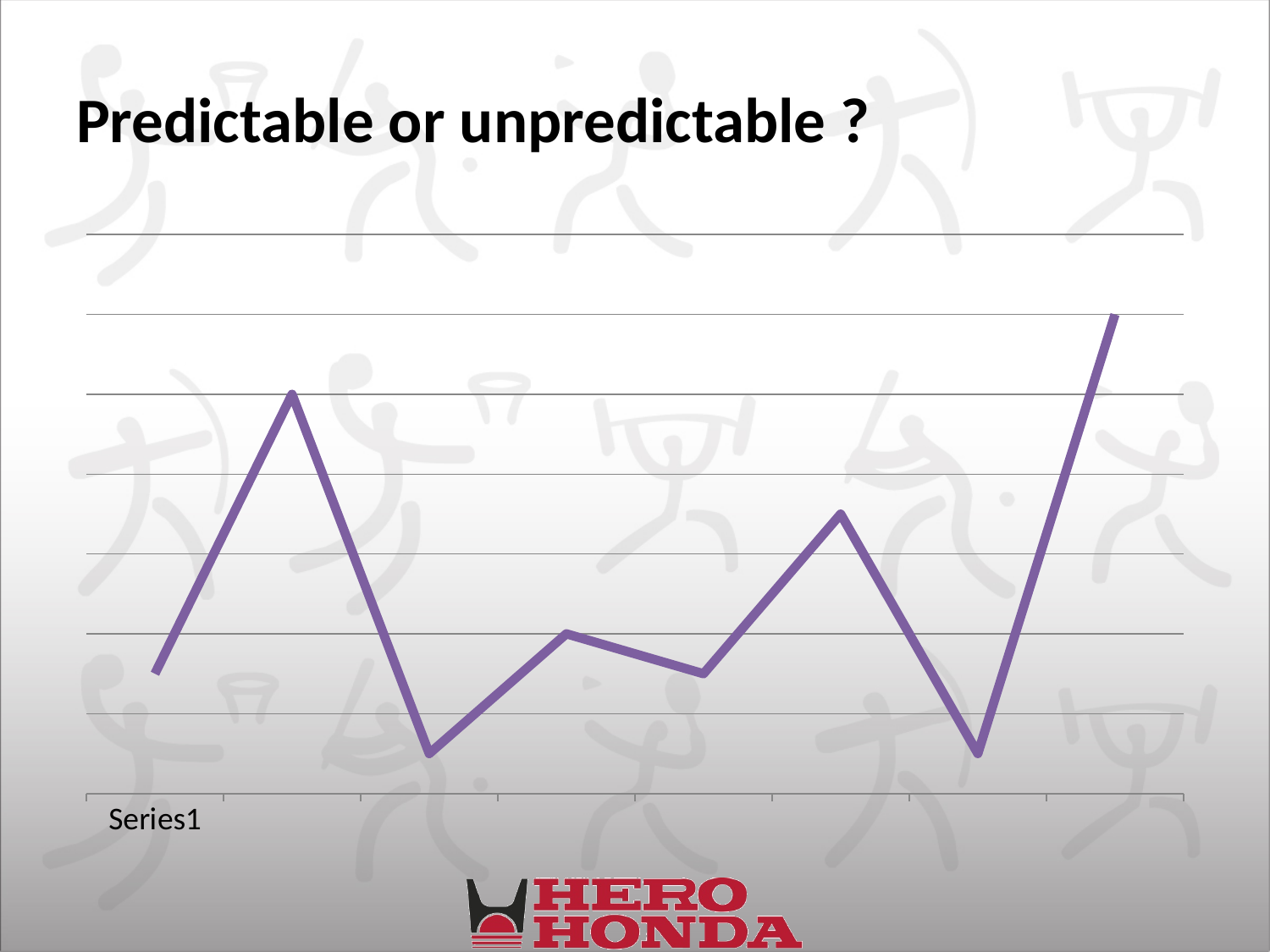
What is the name of the series shown on the chart? Series1 Does the line rise or fall between the second and third data points? fall Does the line rise or fall between the seventh and eighth data points? rise Is the second data point higher or lower than the sixth data point? higher Is the first data point higher or lower than the second data point? lower What kind of chart is shown on the slide? line chart Which data point has the highest value, the first or the last? the last How many series does the chart show? 1 How many data points are plotted on the line? 8 What colour is the plotted line? purple Do the values rise steadily, fall steadily, or fluctuate along the x axis? fluctuate